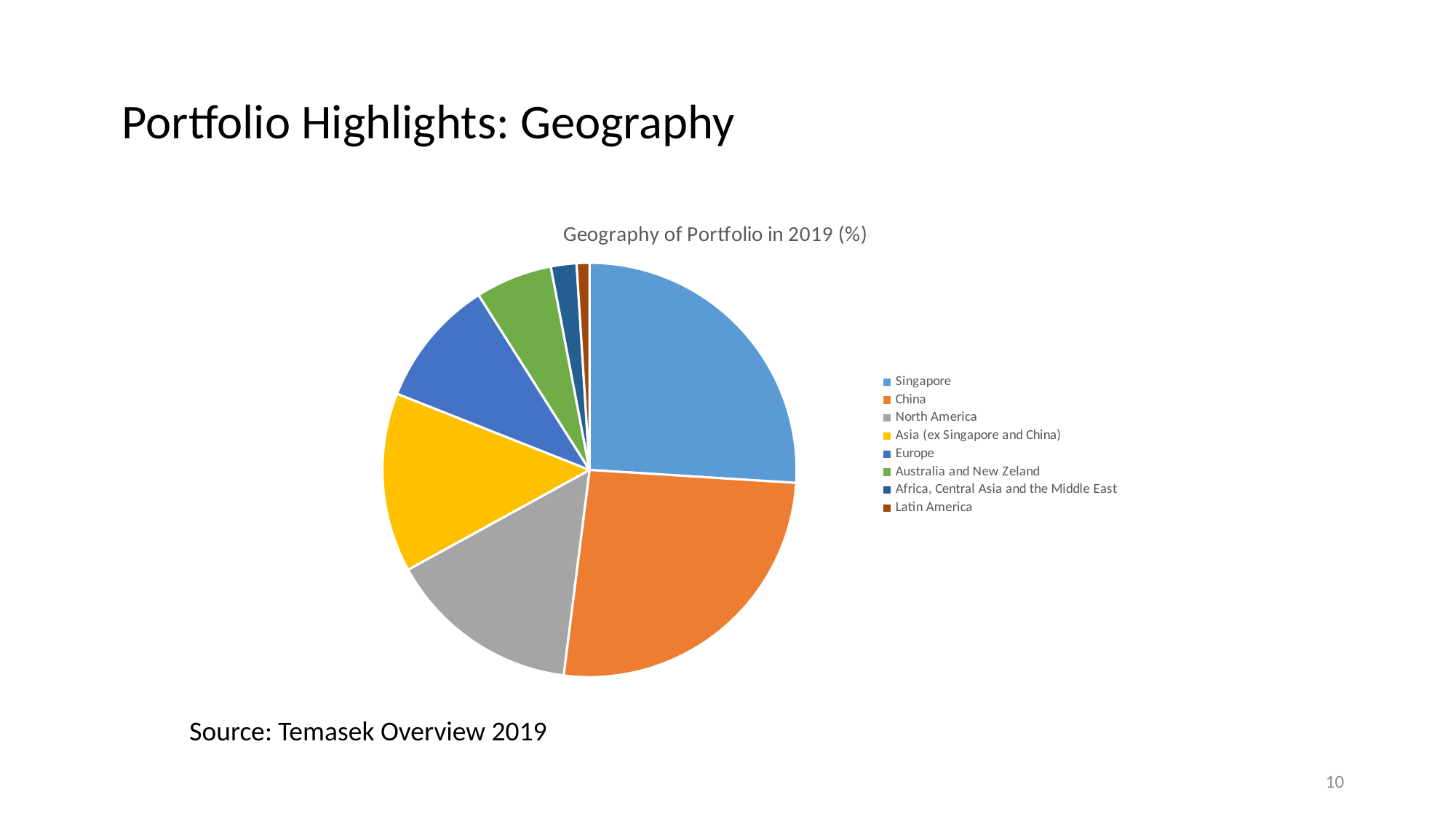
What kind of chart is shown on the slide? pie chart How many entries does the legend list? 8 Which category has the smallest slice of the pie? Latin America Which slice is larger, North America or Australia and New Zeland? North America Which category is shown in orange in the pie chart? China What is the title of the chart? Geography of Portfolio in 2019 (%) How many categories (slices) does the pie chart have? 8 Which slice is larger, Singapore or Europe? Singapore Which slice is larger, Europe or Latin America? Europe